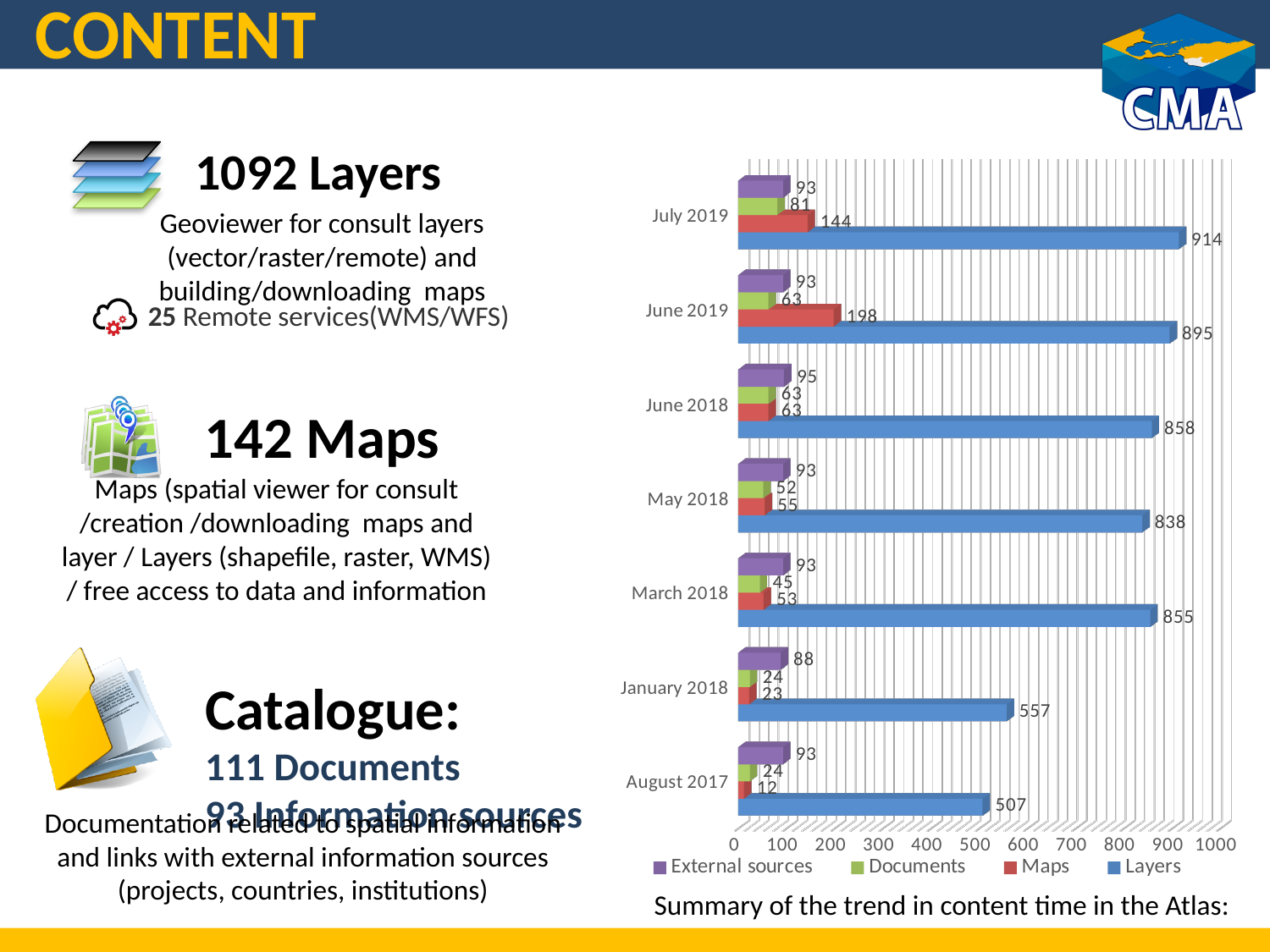
Which time period has the lowest value for Maps? August 2017 How many time periods are shown on the chart? 7 Which is larger, the Maps value for June 2019 or the Maps value for July 2019? June 2019 How many series does the legend list? 4 Which colour represents the Layers series in the chart? Blue What is the value for Maps in June 2019? 198 What kind of chart is shown on the slide? Bar chart What is the value for Documents in August 2017? 24 What is the value for External sources in January 2018? 88 What is the difference between the Layers values for July 2019 and August 2017? 407 What is the value for Layers in July 2019? 914 Which time period has the highest value for Layers? July 2019